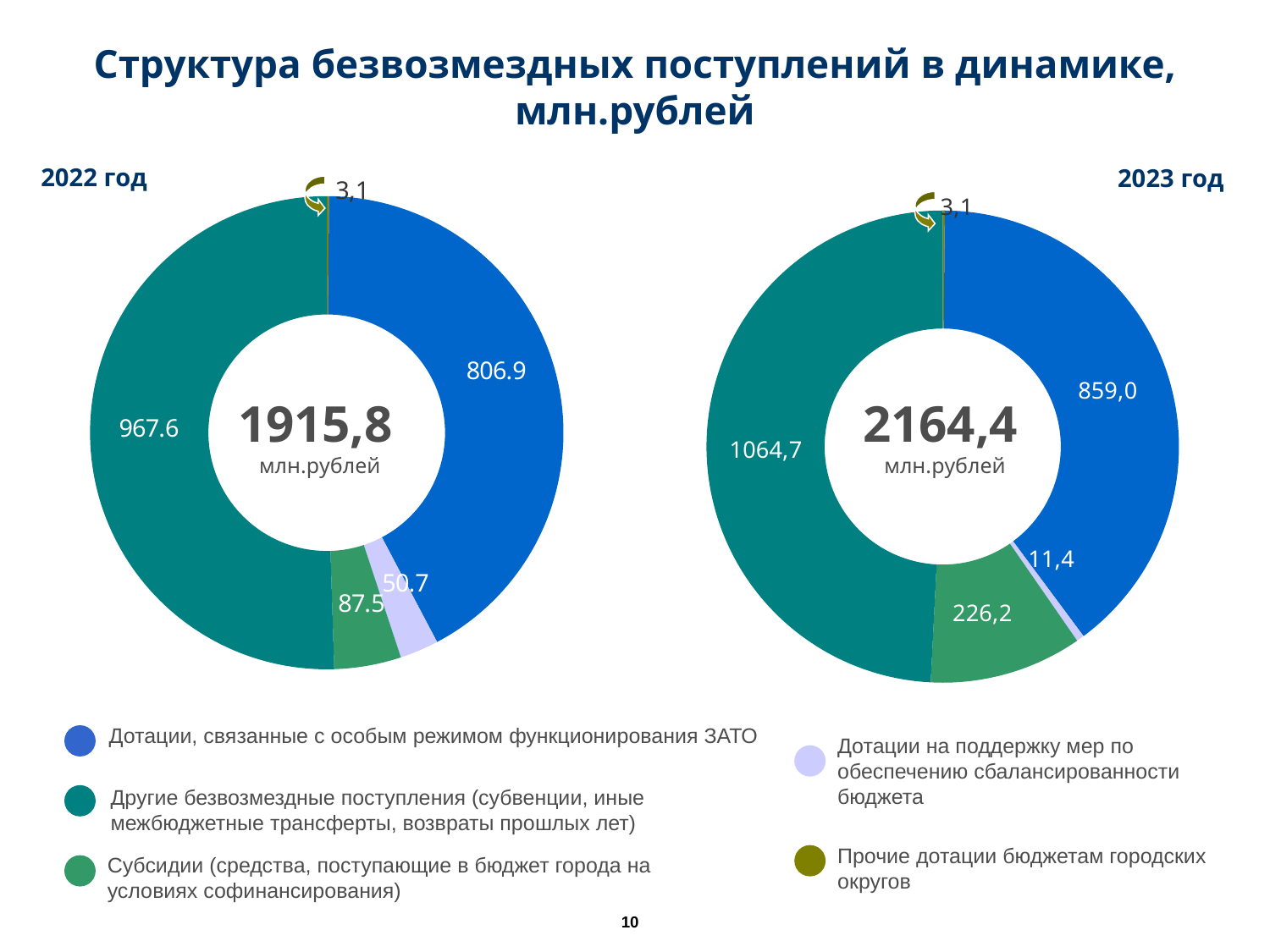
In the 2022 год chart, what is the value for Дотации, связанные с особым режимом функционирования ЗАТО? 806.9 In the 2022 год chart, which is larger: the value for Субсидии or the value for Дотации на поддержку мер по обеспечению сбалансированности бюджета? Субсидии How many categories are shown in the 2023 год chart? 5 In the 2023 год chart, which category has the smallest value? Прочие дотации бюджетам городских округов What total is shown in the centre of the 2023 год chart? 2164,4 млн.рублей Which colour represents Прочие дотации бюджетам городских округов in the legend? Olive (dark yellow-green) What is the difference between the Субсидии value in the 2023 год chart and the Субсидии value in the 2022 год chart? 138,7 In the 2023 год chart, what is the value for Другие безвозмездные поступления (субвенции, иные межбюджетные трансферты, возвраты прошлых лет)? 1064,7 In the 2022 год chart, which category has the largest value? Другие безвозмездные поступления (субвенции, иные межбюджетные трансферты, возвраты прошлых лет) What type of chart is used on this slide for the 2022 and 2023 data? Pie (donut) chart In the 2022 год chart, what is the value for Дотации на поддержку мер по обеспечению сбалансированности бюджета? 50.7 In the 2023 год chart, what is the value for Субсидии (средства, поступающие в бюджет города на условиях софинансирования)? 226,2